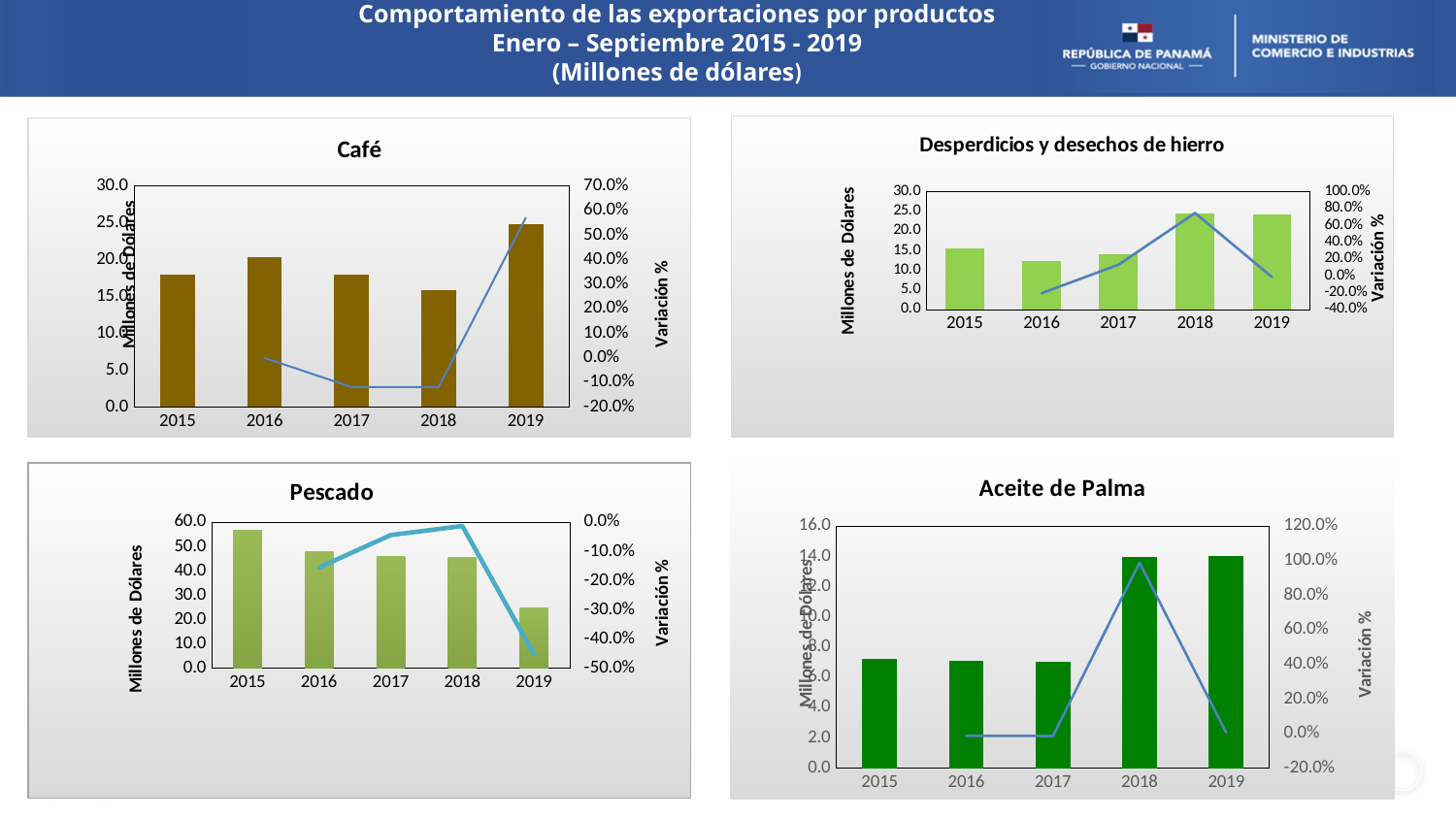
In the Pescado chart, which year has the highest bar? 2015 In the Aceite de Palma chart, is the bar value for 2018 greater or less than 12.0? greater In the Desperdicios y desechos de hierro chart, is the bar value for 2018 greater or less than 20.0? greater In the Café chart, is the bar value for 2019 greater or less than 20.0? greater In the Pescado chart, which bar is taller, 2015 or 2016? 2015 In the Pescado chart, which year has the lowest bar? 2019 How many years are shown on the x axis of the Aceite de Palma chart? 5 In the Café chart, which year has the lowest bar for Millones de Dólares? 2018 In the Desperdicios y desechos de hierro chart, which year has the lowest bar? 2016 In the Pescado chart, do the bar values rise or fall from 2015 to 2019? fall In the Café chart, which year has the highest bar for Millones de Dólares? 2019